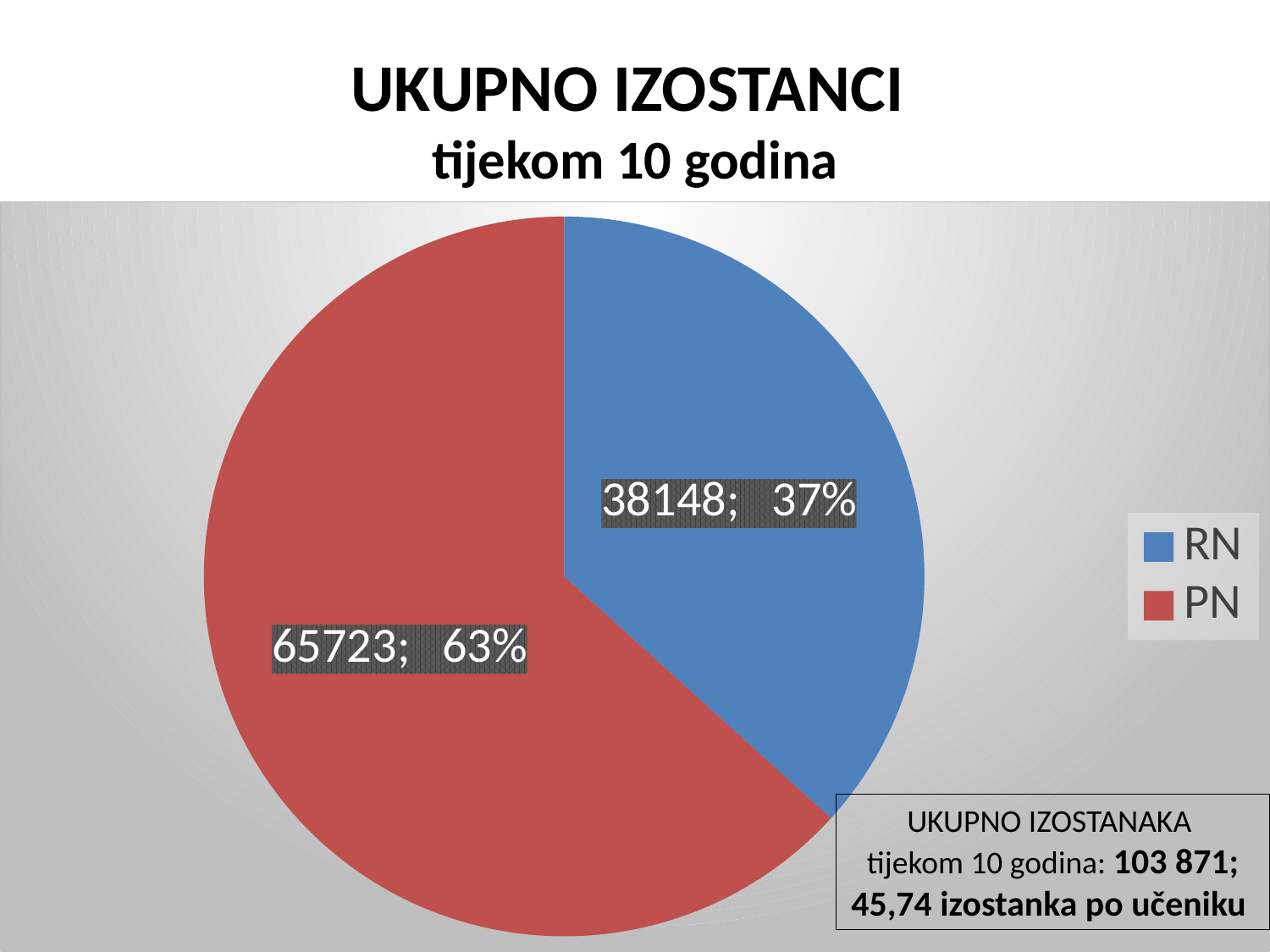
What share of the pie does RN represent? 37% What is the value for PN? 65723 Which is larger, the value for RN or the value for PN? PN What is the value for RN? 38148 What is the title of the chart? UKUPNO IZOSTANCI tijekom 10 godina Which category has the largest slice? PN What share of the pie does PN represent? 63% What colour is the PN slice? red What kind of chart is shown on the slide? pie chart Which category has the smallest slice? RN What is the difference between the values for PN and RN? 27575 How many slices does the pie chart have? 2